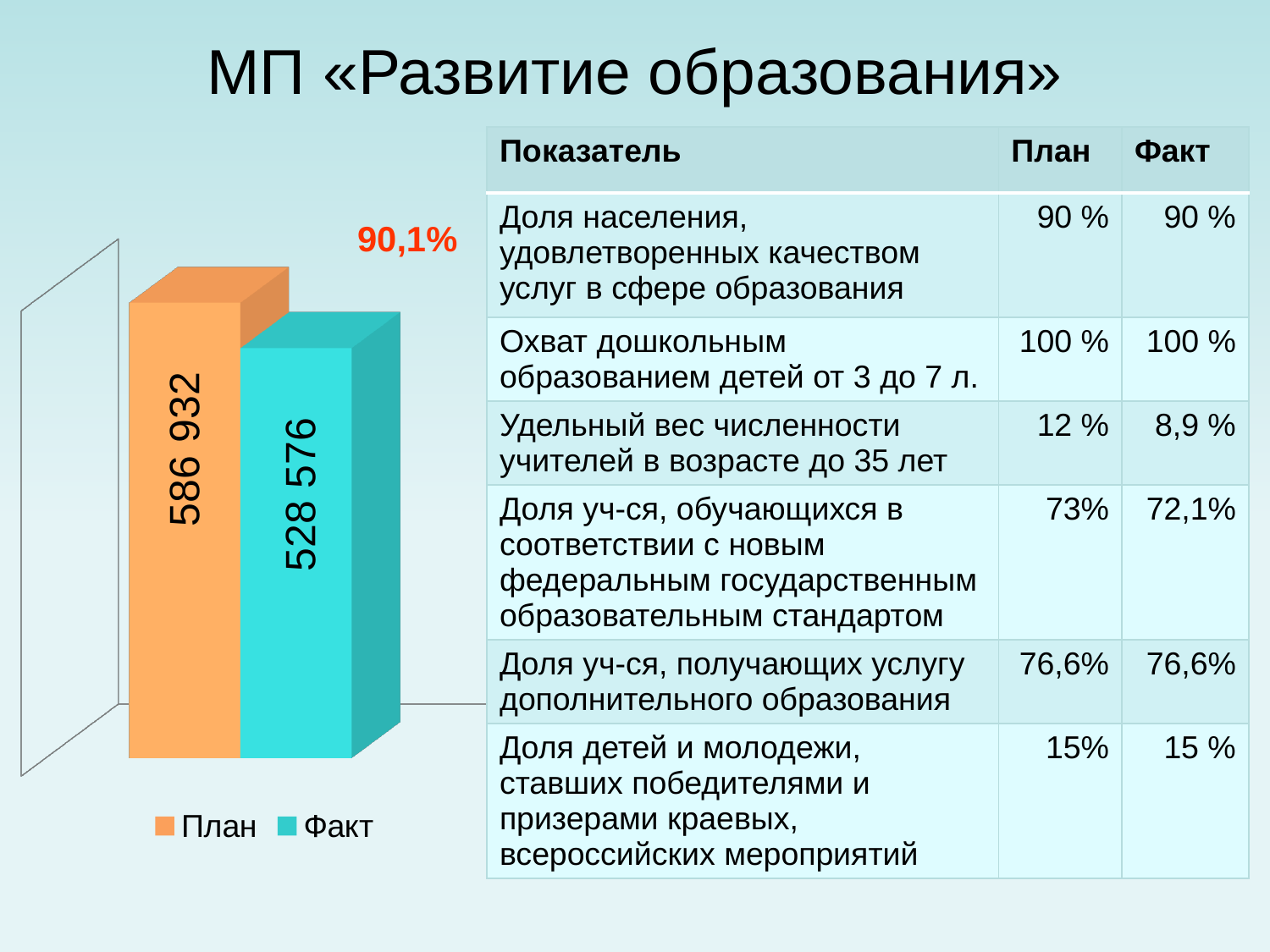
How many bars are plotted in the chart? 2 What is the value of the План bar in the chart? 586 932 How many series does the chart legend list? 2 Which series has the highest value in the chart? План What percentage is printed above the bars in the chart? 90,1% Which bar in the chart is higher, План or Факт? План What kind of chart is shown on the slide? Bar chart What is the difference between the План and Факт values in the chart? 58 356 What is the value of the Факт bar in the chart? 528 576 Which series has the lowest value in the chart? Факт What colour is the Факт bar in the chart? Turquoise